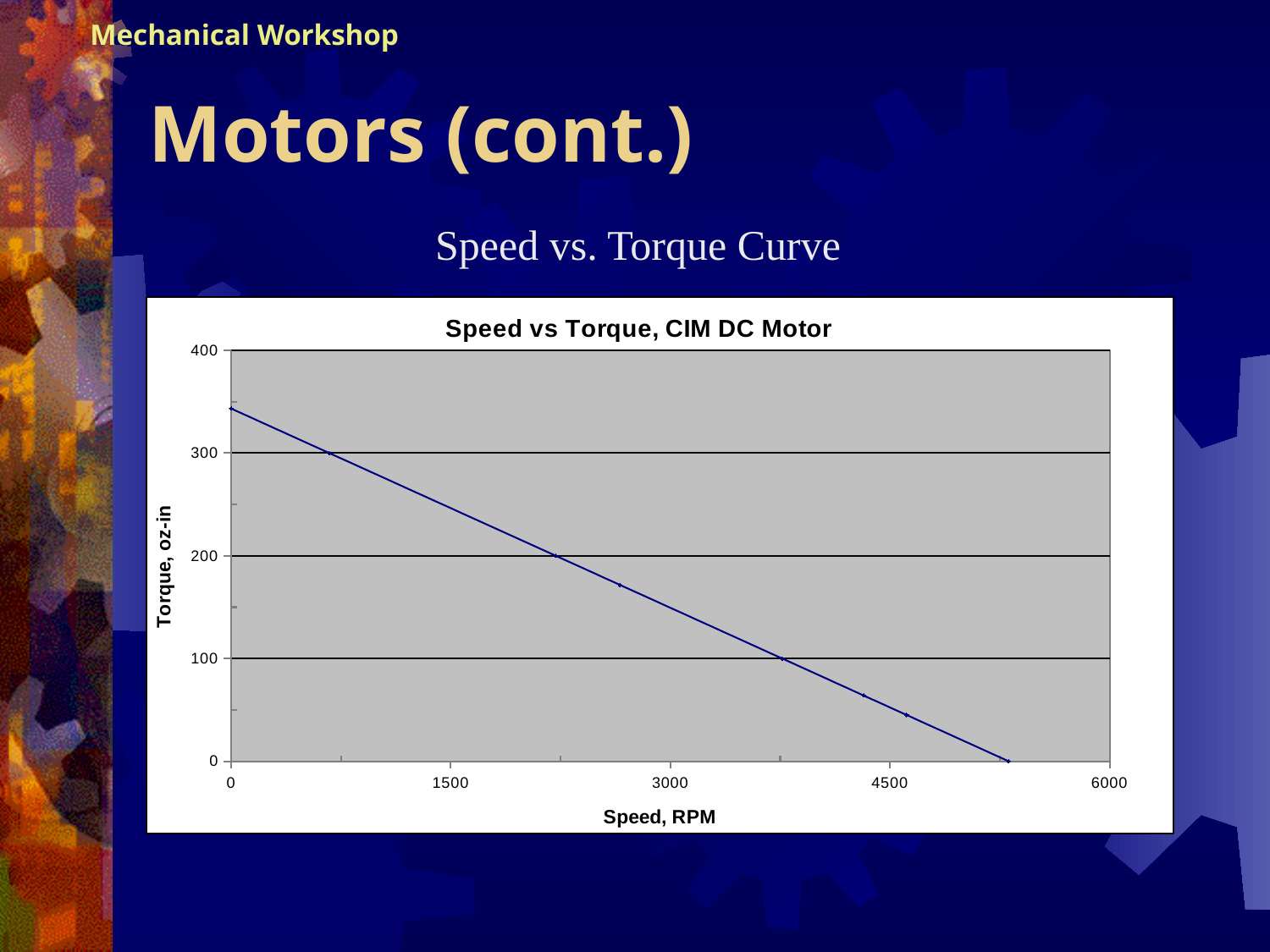
Is the torque at 0 RPM greater or less than 300? greater Does torque rise or fall as speed increases along the x axis? fall At which speed shown on the x axis is the torque highest, 0 RPM or 4500 RPM? 0 RPM Is the torque at 1500 RPM greater or less than 200? greater What is the title of the chart? Speed vs Torque, CIM DC Motor What kind of chart is shown on the slide? line chart What is the label of the vertical axis? Torque, oz-in Is the torque at 3000 RPM greater or less than 100? greater What is the highest value shown on the vertical axis? 400